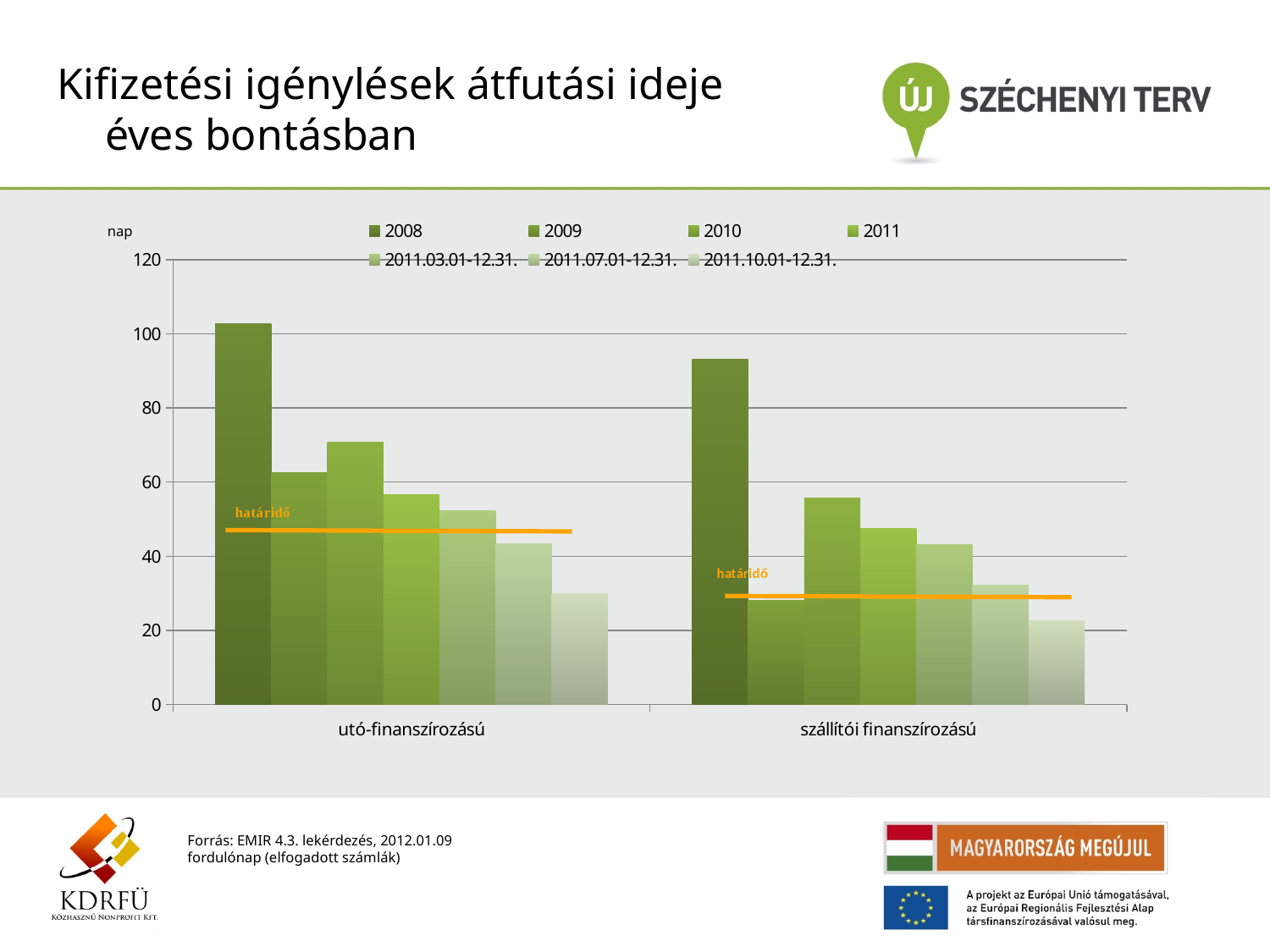
Which series has the highest value in the szállítói finanszírozású category? 2008 Is the 2008 value for utó-finanszírozású greater or less than 100? greater What unit label is shown at the top of the vertical axis? nap Is the 2008 value for szállítói finanszírozású greater or less than 100? less Is the 2010 value for szállítói finanszírozású greater or less than 60? less How many series does the chart legend list? 7 How many categories are shown on the x axis of the chart? 2 Which series has the lowest value in the utó-finanszírozású category? 2011.10.01-12.31. What kind of chart is shown on the slide? bar chart Which series has the highest value in the utó-finanszírozású category? 2008 Which category has the larger 2008 value, utó-finanszírozású or szállítói finanszírozású? utó-finanszírozású